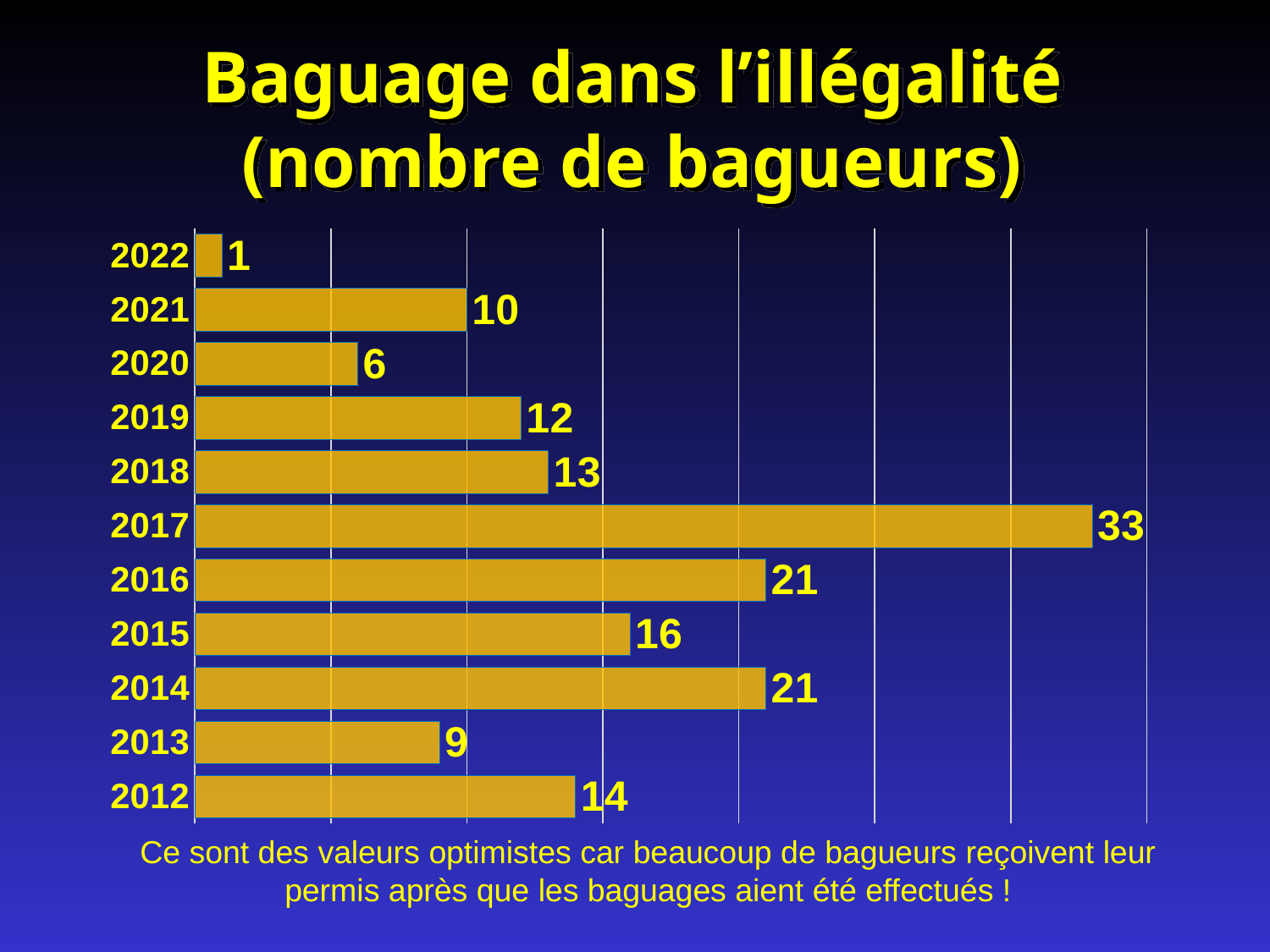
What is the number of bagueurs for 2015? 16 What is the difference between the values for 2017 and 2016? 12 What is the number of bagueurs for 2017? 33 Which is larger, the value for 2019 or the value for 2013? 2019 What is the number of bagueurs for 2022? 1 What is the number of bagueurs for 2012? 14 What is the difference between the values for 2021 and 2020? 4 Which year has the highest number of bagueurs? 2017 Which year has the lowest number of bagueurs? 2022 What kind of chart is shown on the slide? bar chart What is the title of the chart? Baguage dans l'illégalité (nombre de bagueurs) How many years are shown on the chart? 11